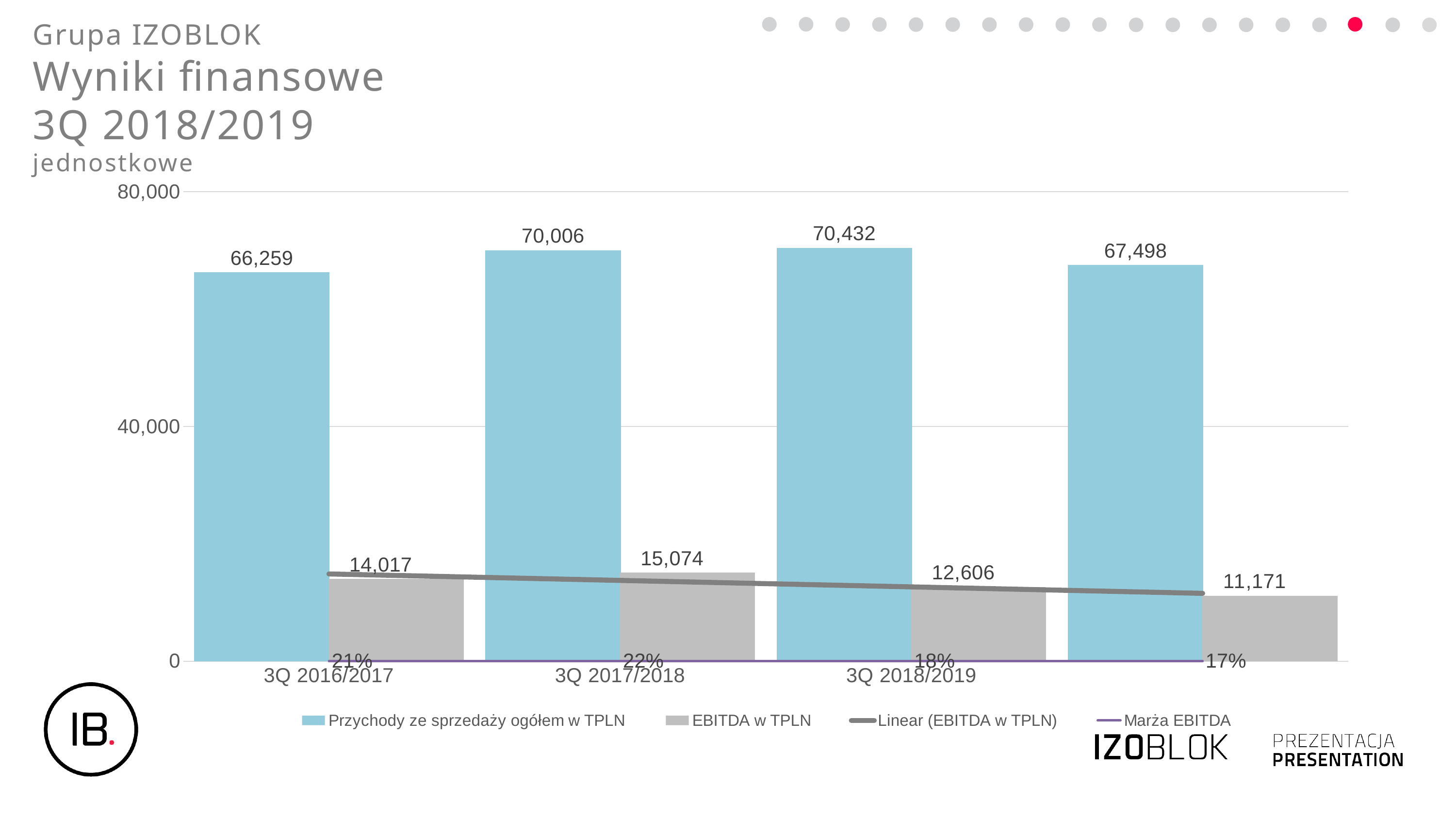
What is the difference in Przychody ze sprzedaży ogółem w TPLN between 3Q 2018/2019 and 3Q 2016/2017? 4,173 How many series does the legend list? 4 What is the Przychody ze sprzedaży ogółem w TPLN value for 3Q 2018/2019? 70,432 What is the difference in EBITDA w TPLN between 3Q 2017/2018 and 3Q 2018/2019? 2,468 Does the Linear (EBITDA w TPLN) trend line rise or fall from left to right? fall What is the value of Przychody ze sprzedaży ogółem w TPLN for 3Q 2017/2018? 70,006 Which period has the larger EBITDA w TPLN, 3Q 2016/2017 or 3Q 2017/2018? 3Q 2017/2018 What is the EBITDA w TPLN value for 3Q 2016/2017? 14,017 What is the Marża EBITDA for 3Q 2018/2019? 18% What kind of chart is shown on the slide? combination bar and line chart Is the Przychody ze sprzedaży ogółem w TPLN value for 3Q 2016/2017 greater or less than 40,000? greater Which labelled period has the highest EBITDA w TPLN? 3Q 2017/2018